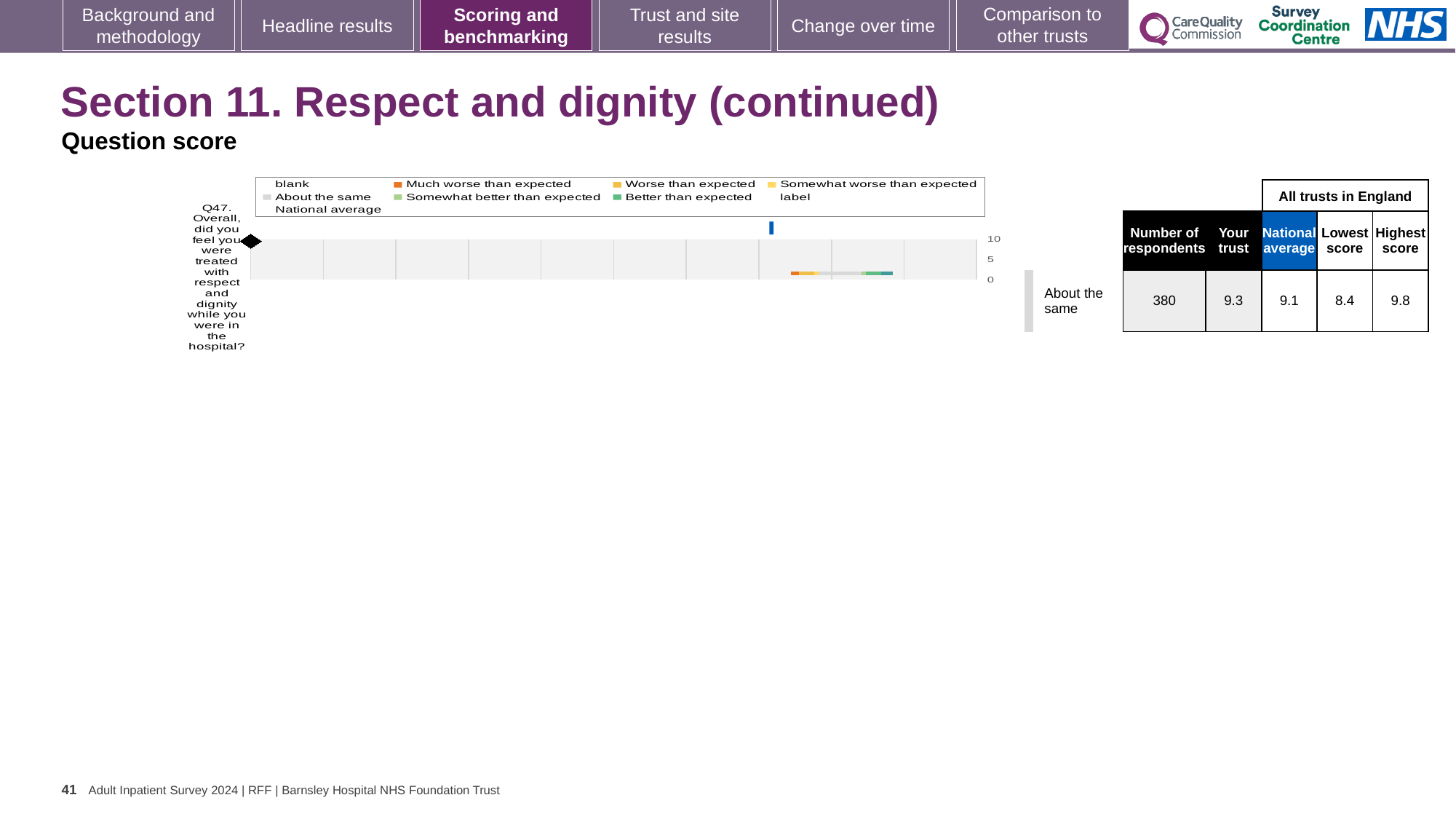
What is the difference between the highest and lowest scores for Q47 across all trusts in England? 1.4 How many respondents answered Q47? 380 How many questions are plotted on the chart? 1 Which is larger for Q47: the trust's score or the national average? Your trust What kind of chart is shown on the slide for Q47? bar chart What is the trust's score for Q47 (treated with respect and dignity)? 9.3 What is the highest tick value shown on the chart's score axis? 10 By how much does the trust's score for Q47 exceed the national average? 0.2 What is the highest score among all trusts in England for Q47? 9.8 What is the national average score for Q47? 9.1 Which benchmarking category is the trust's Q47 result placed in? About the same What is the lowest score among all trusts in England for Q47? 8.4